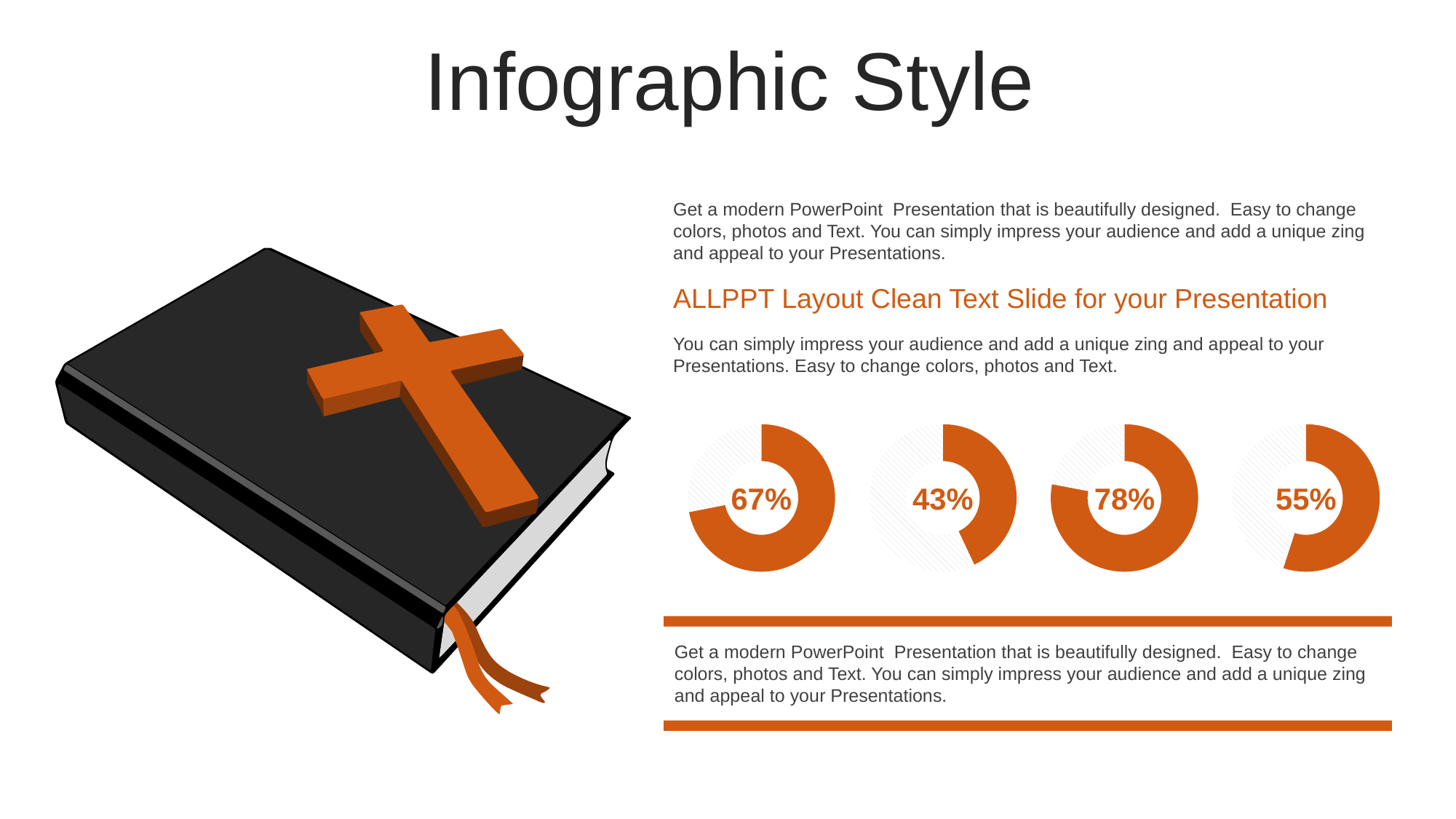
Which of the four donut charts shows the lowest percentage? The second from the left (43%) Which is larger, the value in the leftmost donut chart or the value in the rightmost donut chart? The leftmost (67%) How many donut charts are shown on the slide? 4 What value is shown in the second donut chart from the left? 43% What is the difference between the values in the leftmost and rightmost donut charts? 12% What value is shown in the rightmost donut chart? 55% Which of the four donut charts shows the highest percentage? The third from the left (78%) What is the difference between the values in the third and second donut charts? 35% What value is shown in the third donut chart from the left? 78% What colour is the filled portion of the donut charts? Orange What kind of chart is used to display the percentages on the slide? Donut chart What value is shown in the leftmost donut chart? 67%